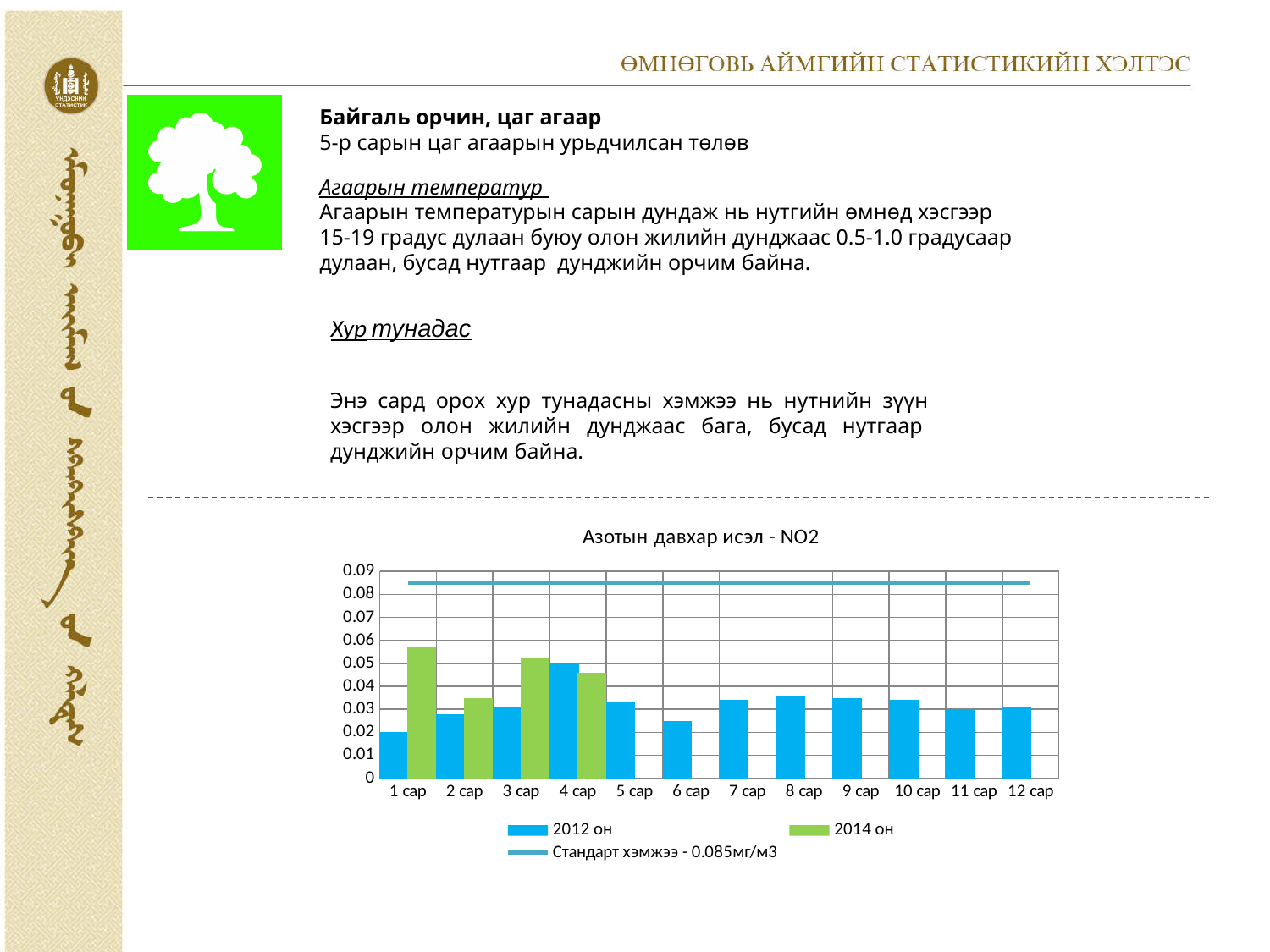
For how many months does the chart show a 2014 он bar? 4 In 1 сар, which series has the larger value, 2012 он or 2014 он? 2014 он How many series does the legend of the NO2 chart list? 3 What standard level does the horizontal line in the chart represent, according to the legend? 0.085мг/м3 How many months are shown on the x axis of the NO2 chart? 12 Among the months with 2014 он data, which has the lowest 2014 он value? 2 сар In which month is the 2012 он value lowest? 1 сар What kind of chart is shown on the slide? bar chart Is the 2014 он value for 1 сар greater or less than 0.05? greater In which month is the 2012 он value highest? 4 сар Is the 2012 он value for 1 сар greater or less than 0.03? less Is the 2012 он value for 6 сар greater or less than 0.03? less